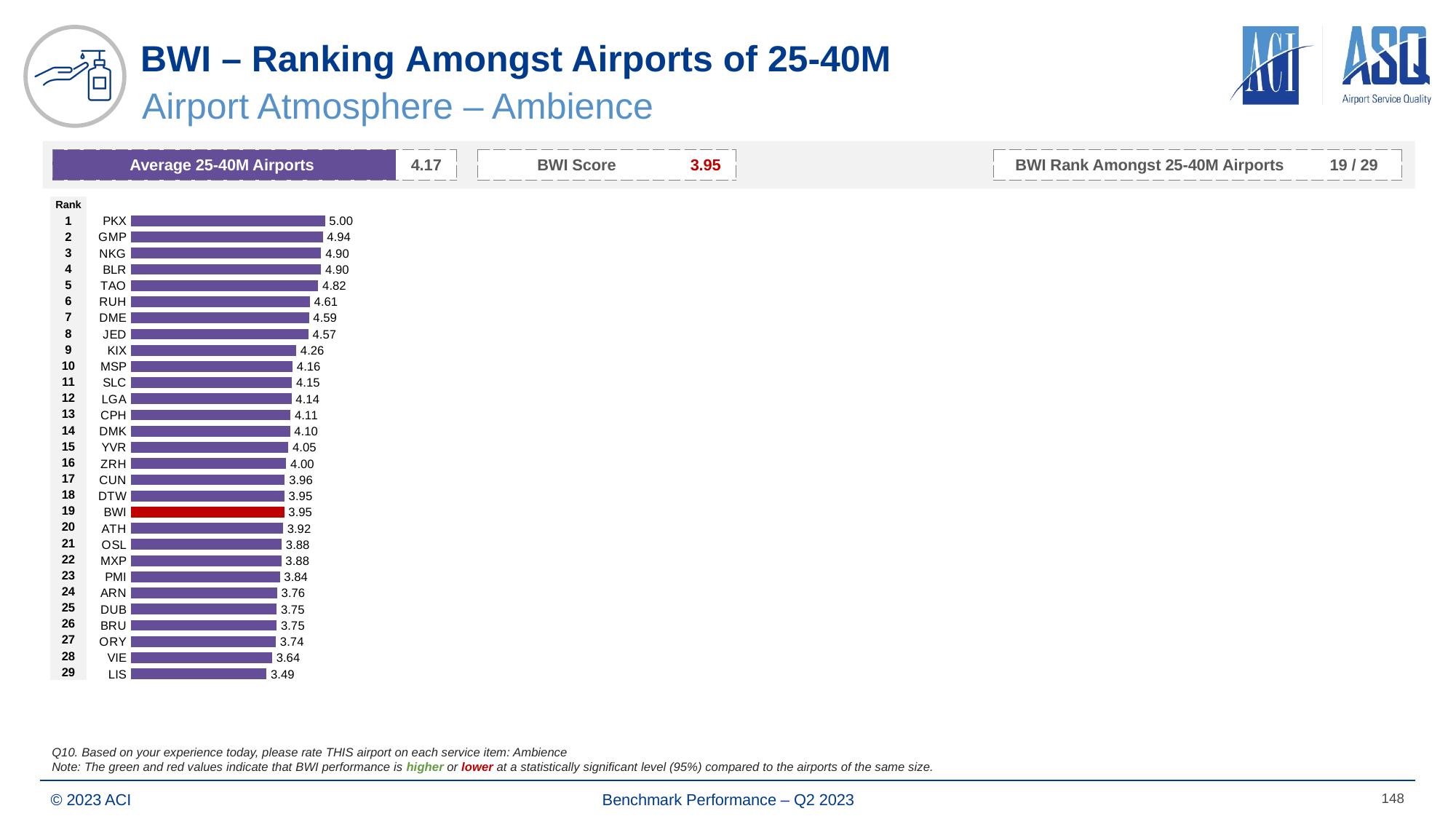
What is the value for BWI? 3.95 Which bar is coloured red in the chart? BWI What is the value for PKX? 5.00 Which airport has the highest value? PKX What kind of chart is shown on the slide? Bar chart What is the difference between the values for BWI and ATH? 0.03 Which airport has the lowest value? LIS What is the value for LIS? 3.49 How many airports are shown in the chart? 29 Which has a larger value, RUH or VIE? RUH What is the difference between the values for PKX and LIS? 1.51 What is the value for KIX? 4.26